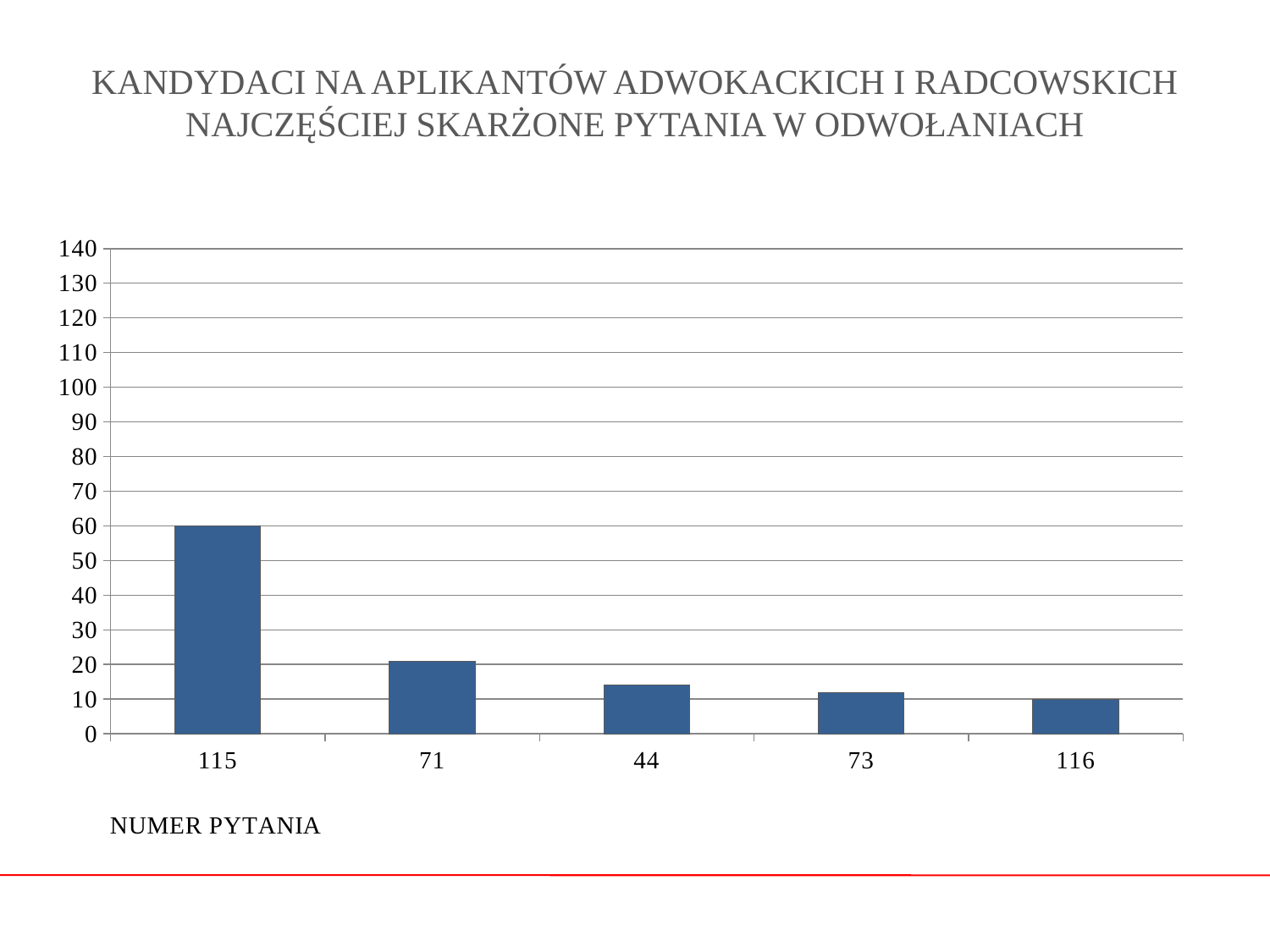
Is the value for question 44 greater or less than 20? less Which question number has the highest bar? 115 Is the value for question 71 greater or less than 30? less Which has a larger value, question 71 or question 116? 71 What is the value for question number 116? 10 What is the difference between the values for question 115 and question 116? 50 Which has a larger value, question 115 or question 71? 115 What type of chart is shown on the slide? bar chart What is the label shown below the x axis of the chart? NUMER PYTANIA How many question numbers (categories) are plotted on the x axis? 5 Which question number has the lowest bar? 116 What is the value for question number 115? 60